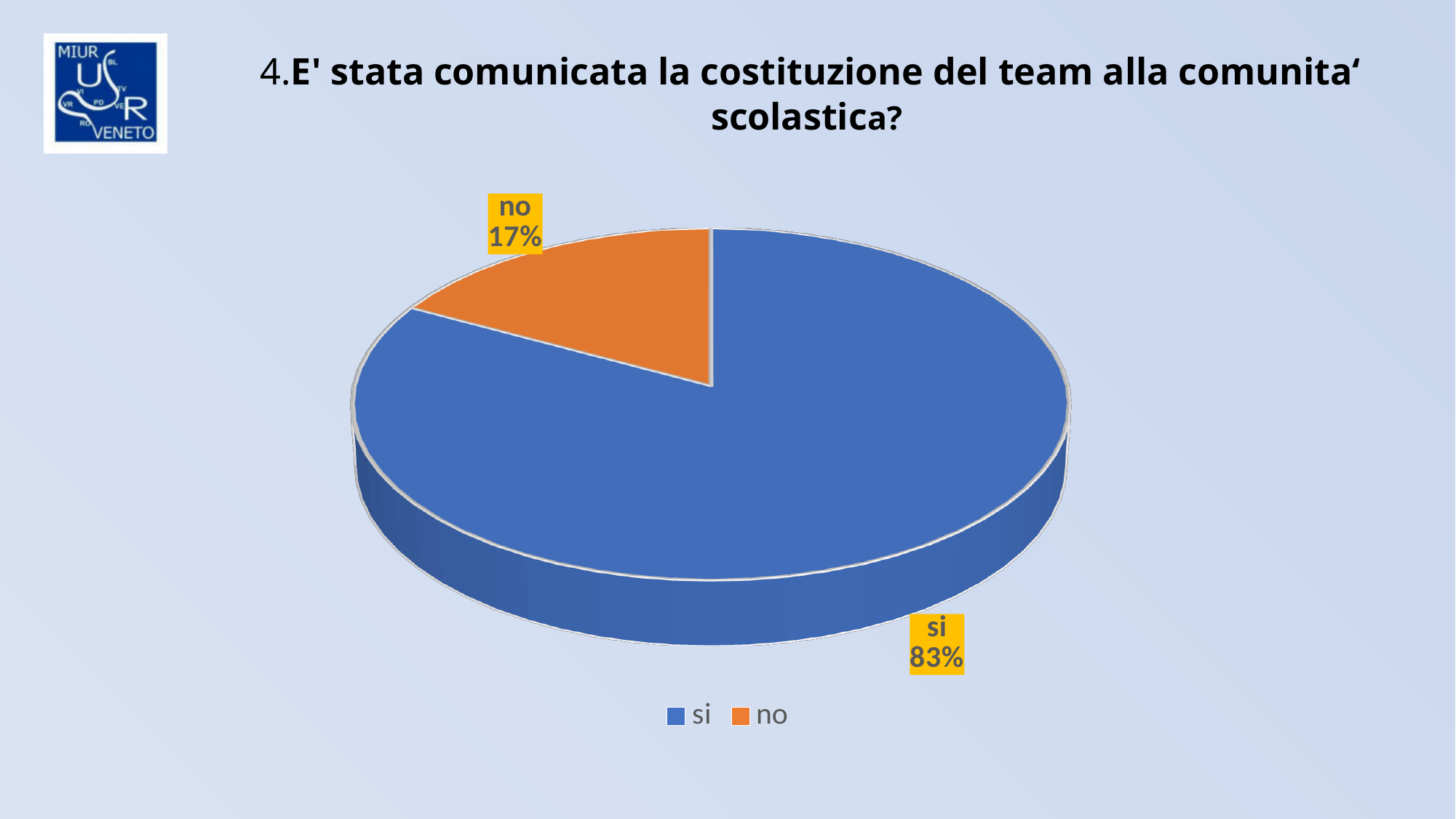
How many slices does the pie chart have? 2 What colour is the "si" slice in the pie chart? blue Which slice of the pie chart is the largest? si Which slice of the pie chart is the smallest? no What percentage of the pie chart is labelled "si"? 83% What is the difference in percentage points between the "si" and "no" slices? 66 What colour is the "no" slice in the pie chart? orange What percentage of the pie chart is labelled "no"? 17% What share of the pie does the "no" slice represent? 17% What kind of chart is shown on the slide? pie chart How many entries does the legend list? 2 Which slice is larger, "si" or "no"? si